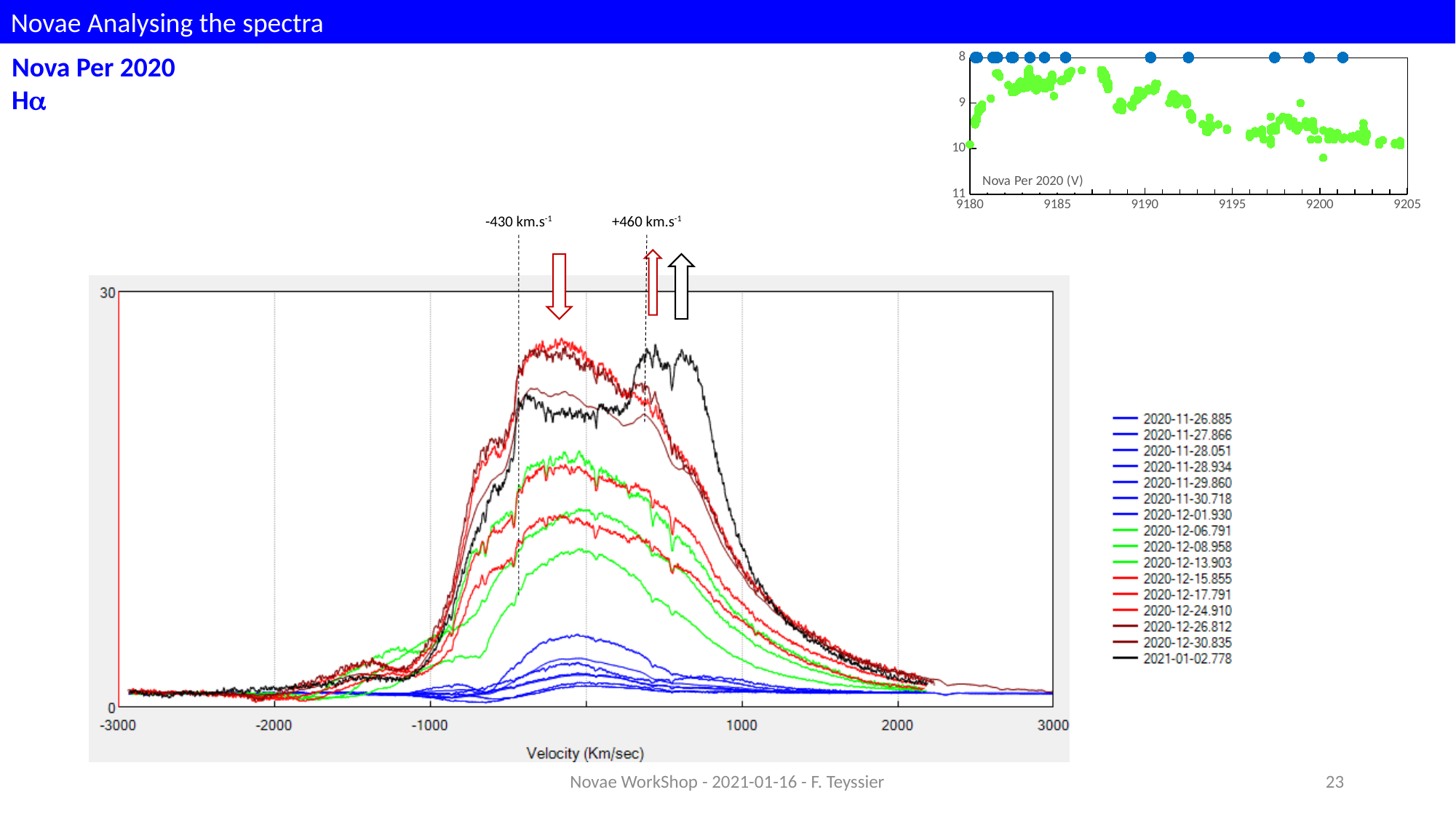
In the large velocity chart, which series is drawn in black? 2021-01-02.778 In the small Nova Per 2020 (V) chart, what is the highest x-axis tick label? 9205 What is the x-axis label of the large velocity chart? Velocity (Km/sec) What velocity is marked by the right dashed line annotation above the large chart? +460 km.s-1 How many series does the legend of the large velocity chart list? 16 In the small Nova Per 2020 (V) chart, are the green points near x = 9200 greater or less than 9? greater How many tick labels are shown on the x axis of the large velocity chart? 7 What is the title printed inside the small chart at the top right of the slide? Nova Per 2020 (V) In the large velocity chart, is the peak of the black 2021-01-02.778 series greater or less than 30? less What kind of chart is the large chart at the bottom left of the slide? line chart What is the first entry in the legend of the large velocity chart? 2020-11-26.885 What velocity is marked by the left dashed line annotation above the large chart? -430 km.s-1